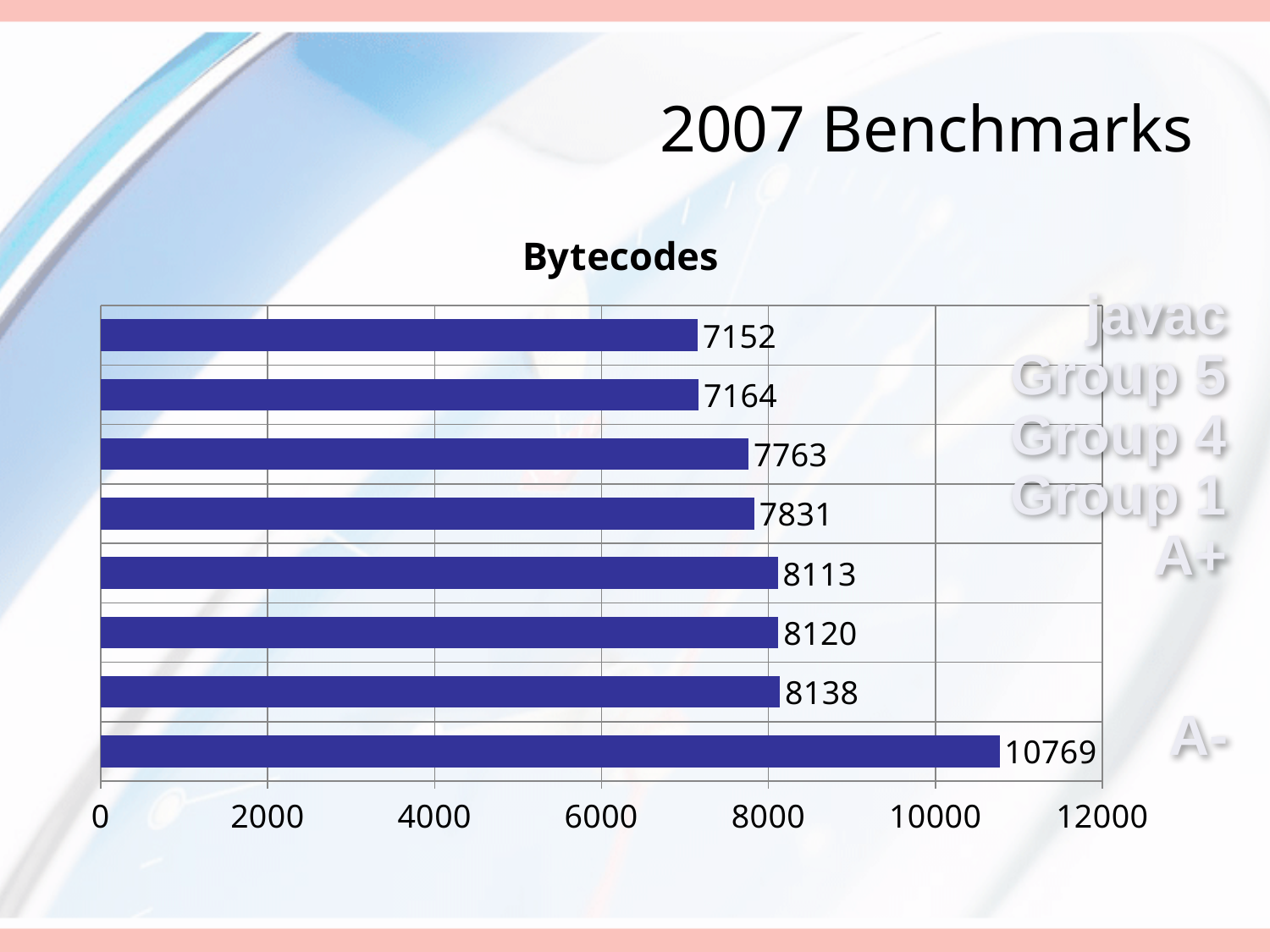
What is the difference between the two smallest values, 7164 and 7152? 12 How many bars are plotted in the chart? 8 What kind of chart is shown on the slide? bar chart What is the value of the longest bar in the chart? 10769 Is the value of the bottom bar greater or less than 10000? greater What is the value of the shortest bar in the chart? 7152 What is the value shown on the bottom bar of the chart? 10769 What is the value shown on the third bar from the top? 7763 What is the value shown on the topmost bar of the chart? 7152 Which is larger, the value of the bottom bar or the value of the top bar? the bottom bar What is the title of the chart? Bytecodes What is the difference between the largest value (10769) and the second largest value (8138)? 2631